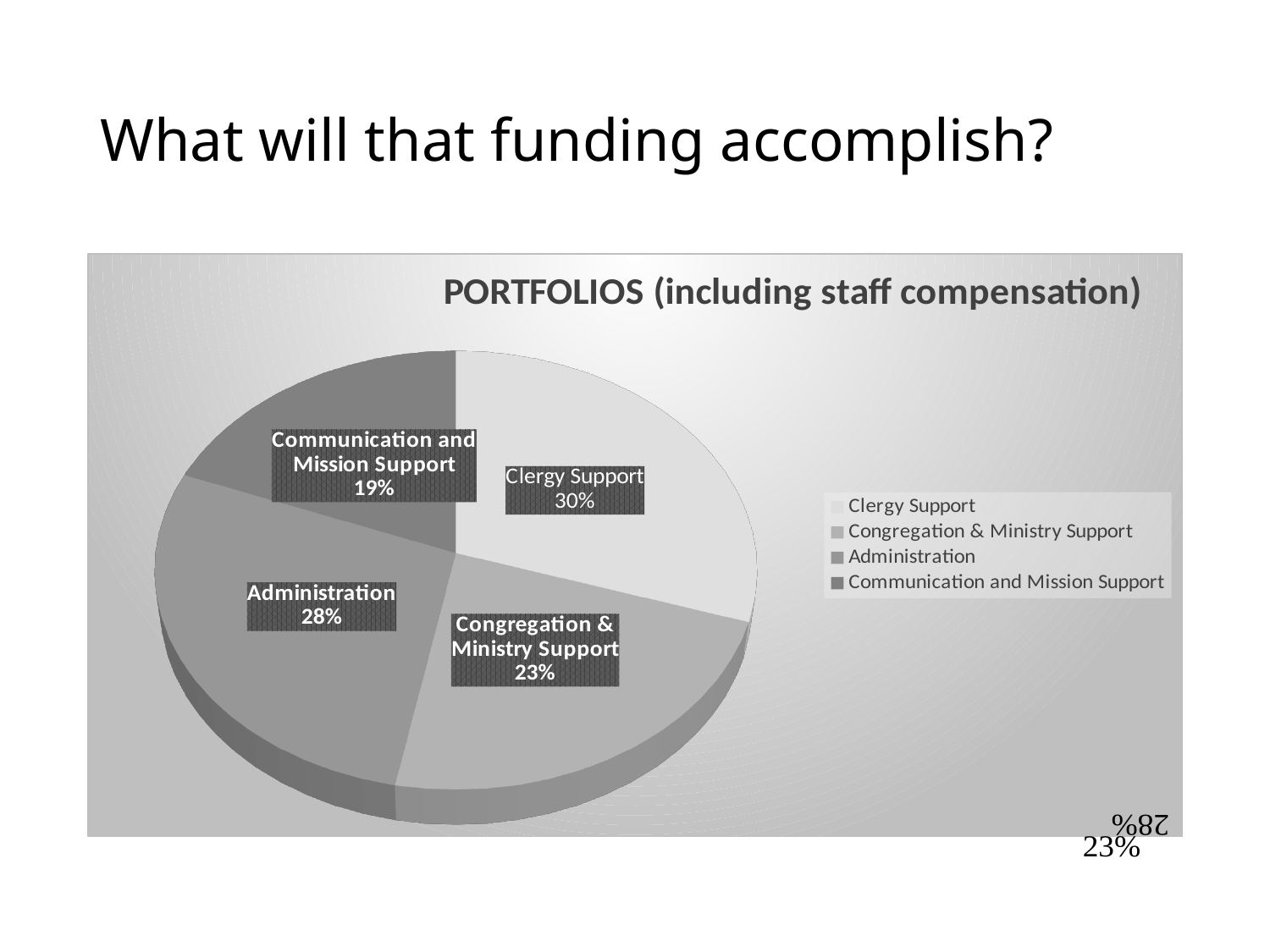
What percentage is shown for Communication and Mission Support? 19% Which category has the smallest share of the pie? Communication and Mission Support Which is larger, the share for Administration or the share for Congregation & Ministry Support? Administration How many slices does the pie chart have? 4 What percentage is shown for Administration? 28% What percentage is shown for Congregation & Ministry Support? 23% What is the difference in percentage points between Administration and Congregation & Ministry Support? 5 What share of the pie does Clergy Support represent? 30% Which category has the largest share of the pie? Clergy Support What is the difference in percentage points between Clergy Support and Communication and Mission Support? 11 What is the title of the chart? PORTFOLIOS (including staff compensation) What kind of chart is shown on the slide? Pie chart